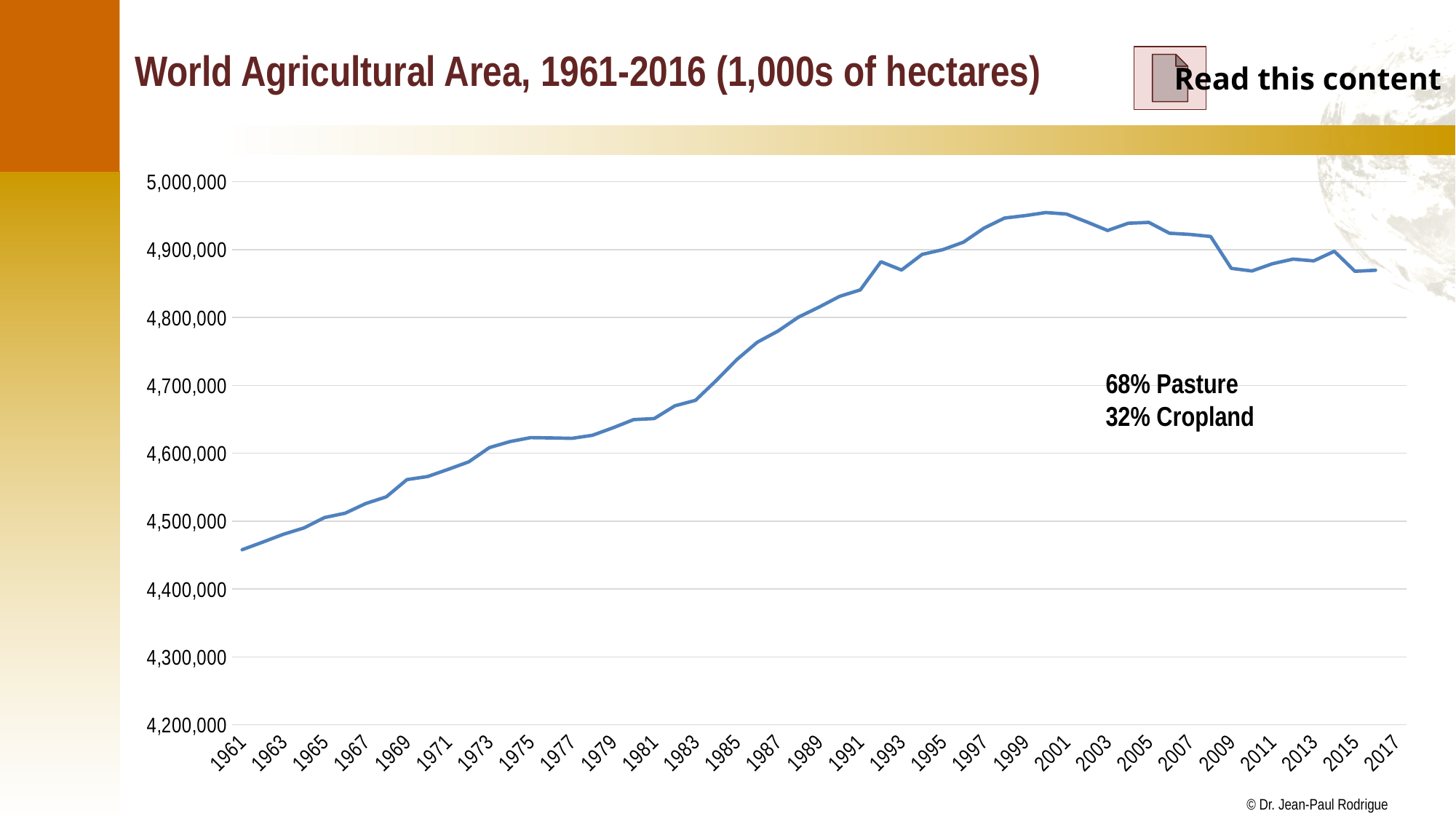
Is the value for 2016 greater or less than 4,800,000? greater Which year has the larger value, 1961 or 2016? 2016 What is the title of the chart? World Agricultural Area, 1961-2016 (1,000s of hectares) Is the value for 1981 greater or less than 4,700,000? less What kind of chart is shown on the slide? line chart Is the value for 1991 greater or less than 4,800,000? greater Do the values rise or fall from 2001 to 2016? fall What share of agricultural area does the annotation on the chart attribute to pasture? 68% Pasture Which year has the lowest value on the chart? 1961 Do the values rise or fall from 1961 to 2000? rise